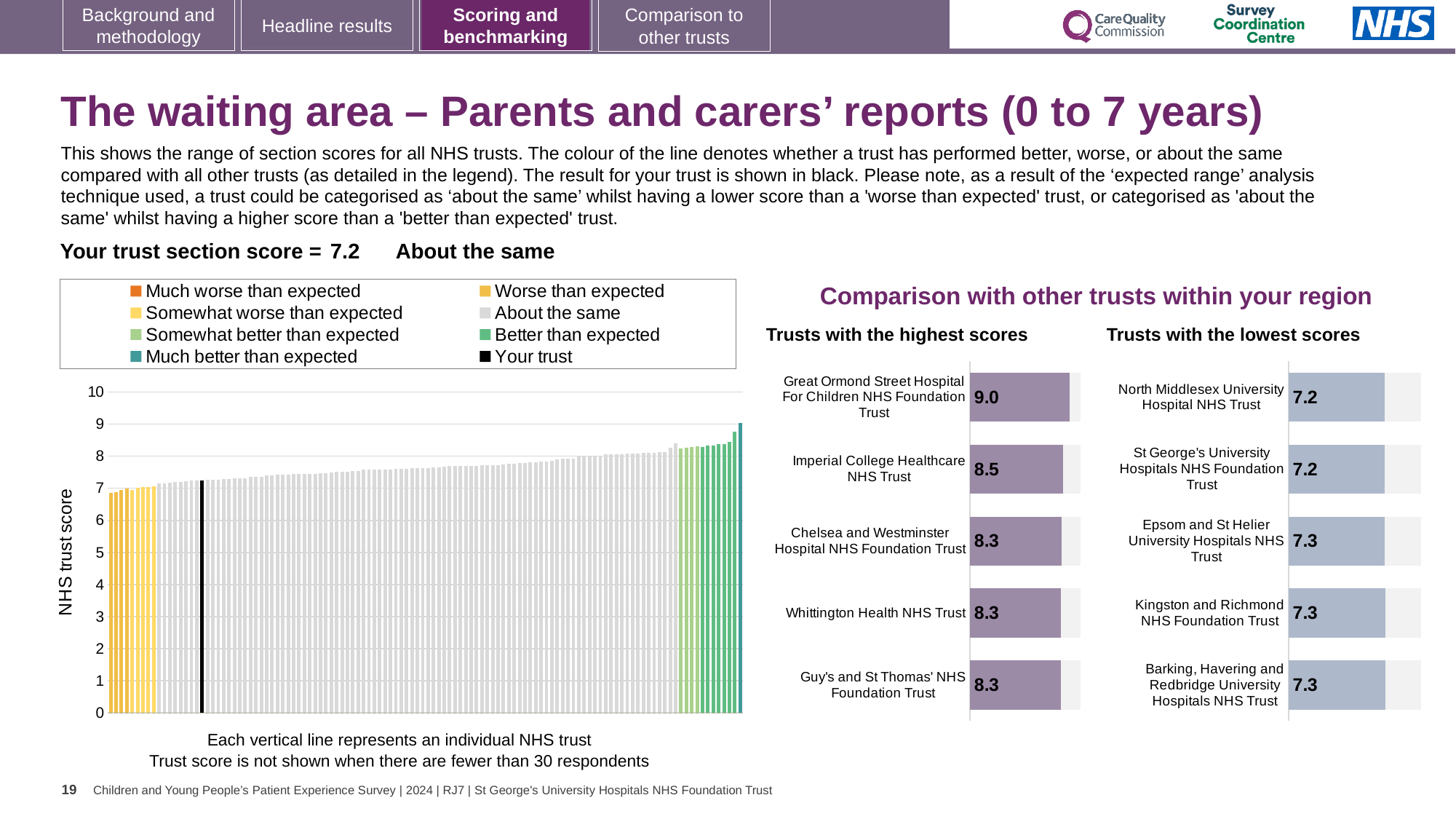
In the 'Trusts with the highest scores' chart, which has the larger score, Imperial College Healthcare NHS Trust or Whittington Health NHS Trust? Imperial College Healthcare NHS Trust In the large chart on the left, how many entries does the legend list? 8 How many trusts are shown in the 'Trusts with the lowest scores' chart? 5 In the 'Trusts with the highest scores' chart, what is the difference between the scores of Great Ormond Street Hospital For Children NHS Foundation Trust and Imperial College Healthcare NHS Trust? 0.5 In the large chart on the left, is the value of the black 'Your trust' bar greater or less than 7? greater In the large chart on the left, do the trust scores rise or fall from left to right? rise In the 'Trusts with the highest scores' chart, which trust has the highest score? Great Ormond Street Hospital For Children NHS Foundation Trust What kind of chart is the large chart on the left with the y axis labelled 'NHS trust score'? bar chart In the 'Trusts with the highest scores' chart, what is the score for Great Ormond Street Hospital For Children NHS Foundation Trust? 9.0 In the 'Trusts with the lowest scores' chart, what is the score for North Middlesex University Hospital NHS Trust? 7.2 In the 'Trusts with the lowest scores' chart, what is the score for Epsom and St Helier University Hospitals NHS Trust? 7.3 In the large chart on the left, is the value of the tallest bar at the far right greater or less than 8? greater